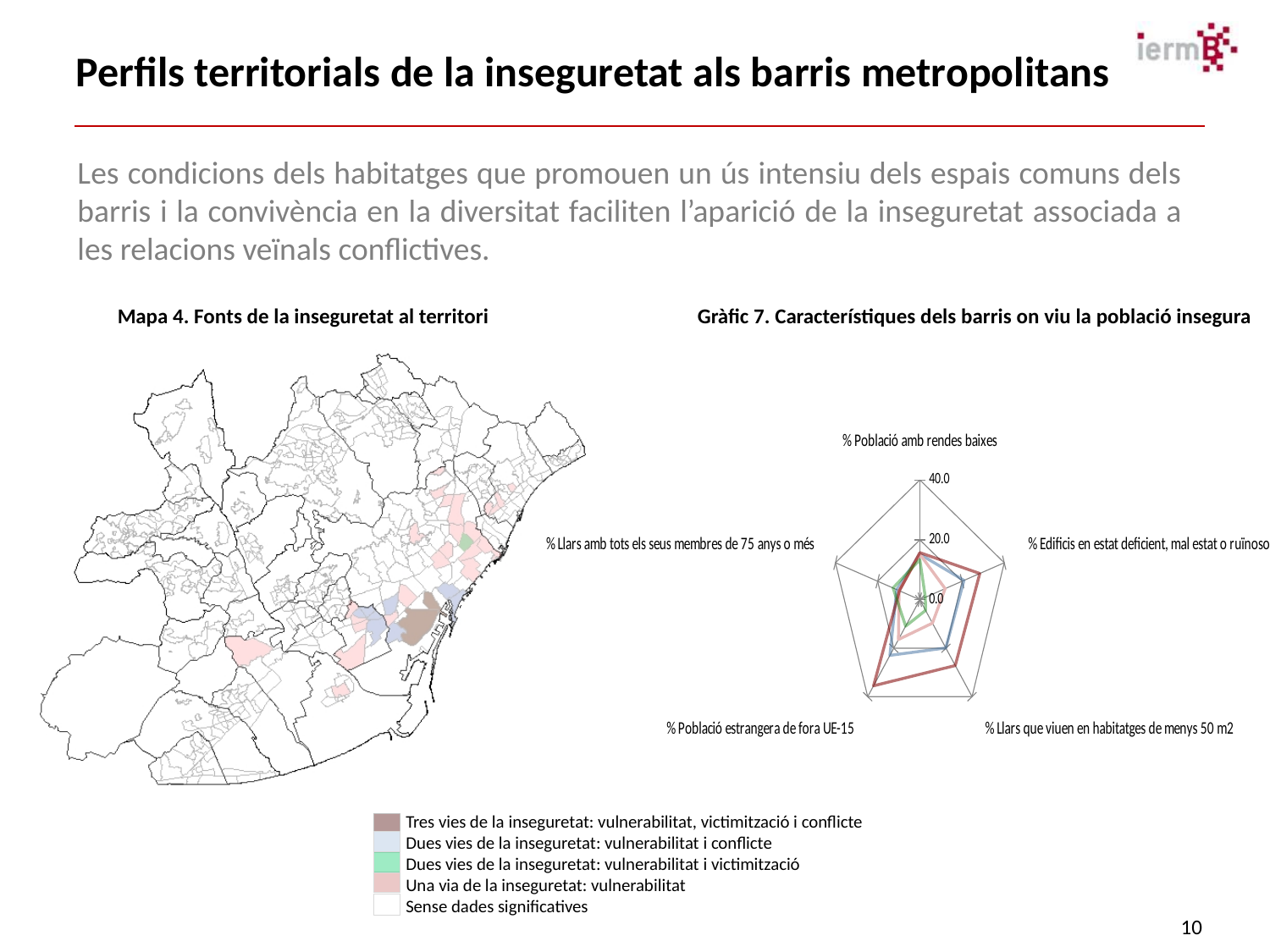
What kind of chart is Gràfic 7. Característiques dels barris on viu la població insegura? Radar chart In Gràfic 7, which series has the larger value for % Població estrangera de fora UE-15, the red series or the green series? Red series How many axes (characteristics) does the radar chart Gràfic 7 have? 5 In Gràfic 7, is the value of the blue series for % Llars amb tots els seus membres de 75 anys o més greater or less than 20.0? less In Gràfic 7, is the value of the red series for % Població estrangera de fora UE-15 greater or less than 20.0? greater What is the highest value shown on the axis scale of the radar chart Gràfic 7? 40.0 What is the title of the chart on the right side of the slide? Gràfic 7. Característiques dels barris on viu la població insegura In Gràfic 7, is the value of the green series for % Edificis en estat deficient, mal estat o ruïnoso greater or less than 20.0? less